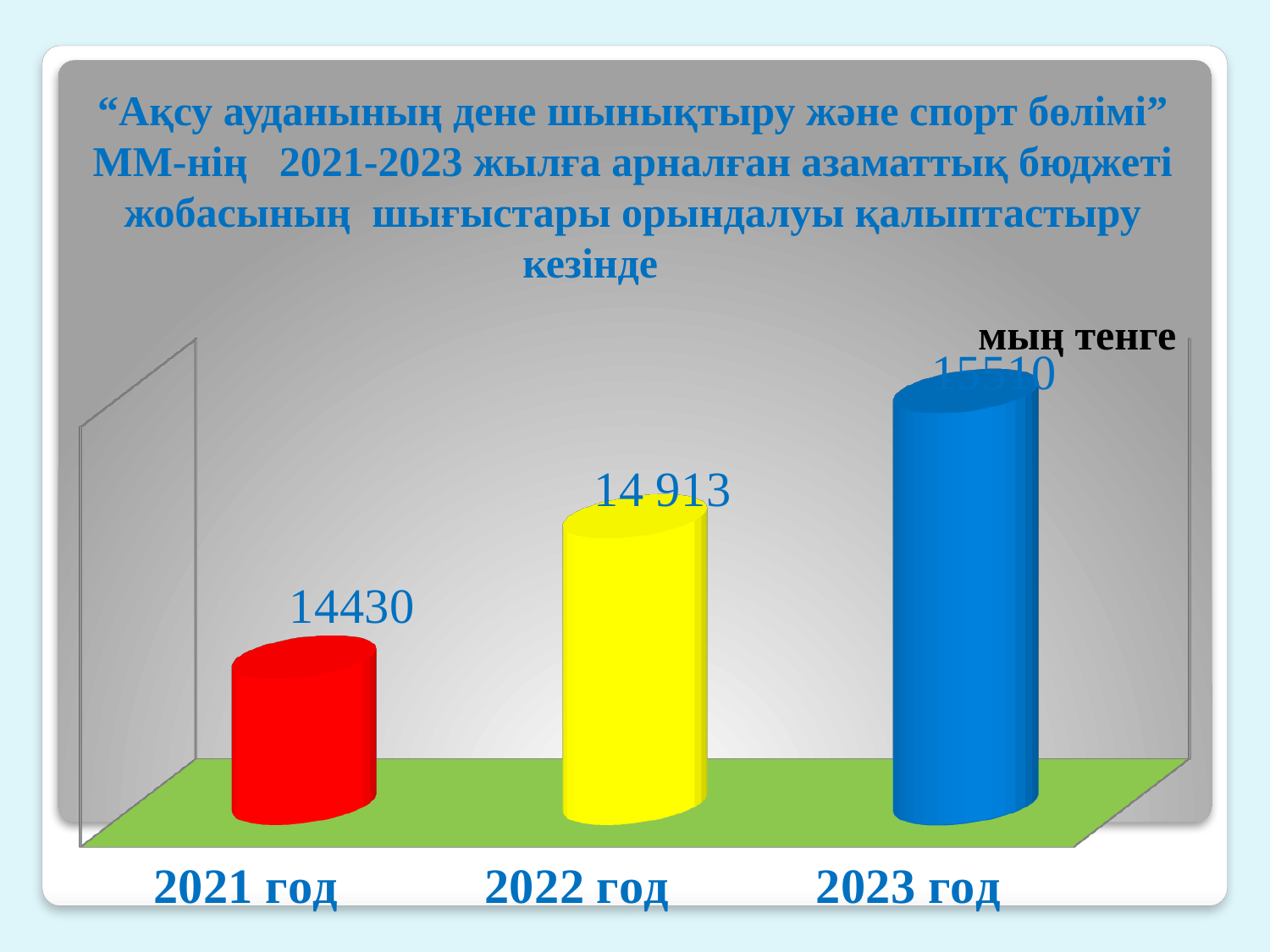
What kind of chart is shown on the slide? bar chart What unit is indicated for the values on the chart? мың тенге Do the values rise or fall from 2021 год to 2023 год? rise What is the value for 2023 год? 15510 What is the difference between the values for 2022 год and 2021 год? 483 What is the difference between the values for 2023 год and 2022 год? 597 What is the value for 2022 год? 14 913 Which year has the highest value? 2023 год Which is larger, the value for 2021 год or the value for 2023 год? 2023 год How many years are shown on the chart? 3 Which year has the lowest value? 2021 год What is the value for 2021 год? 14430